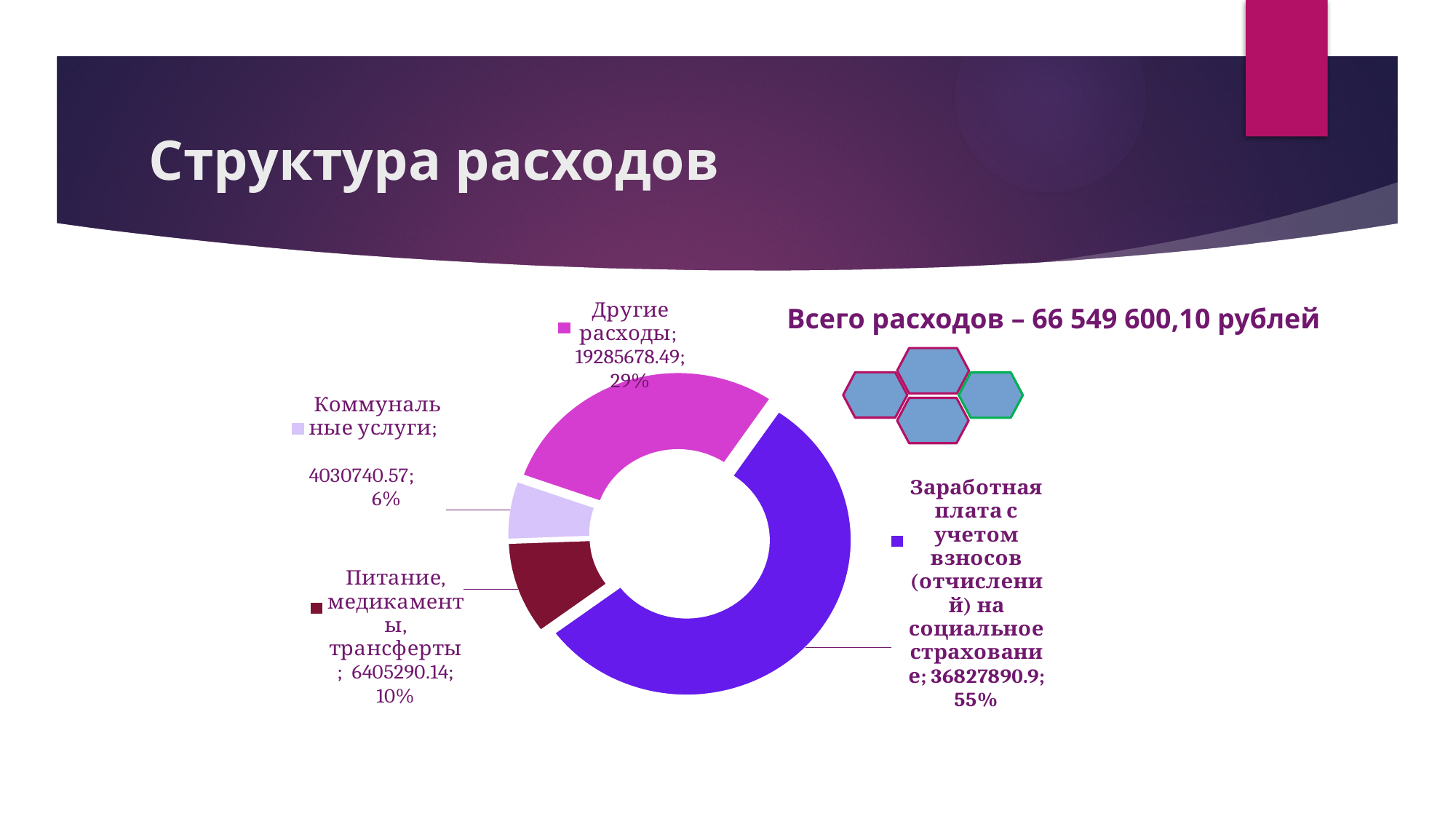
What total expenditure amount is stated on the slide next to the chart? 66 549 600,10 рублей What is the value for Заработная плата с учетом взносов (отчислений) на социальное страхование? 36827890.9 What is the value for Другие расходы? 19285678.49 What is the difference between the value for Заработная плата с учетом взносов (отчислений) на социальное страхование and the value for Другие расходы? 17542212.41 Which category has the smallest share of the chart? Коммунальные услуги What is the value for Коммунальные услуги? 4030740.57 How many categories does the chart show? 4 What share of the chart does Другие расходы represent? 29% What kind of chart is shown on the slide? doughnut (pie) chart What is the value for Питание, медикаменты, трансферты? 6405290.14 Which category has the largest share of the chart? Заработная плата с учетом взносов (отчислений) на социальное страхование What share of the chart does Питание, медикаменты, трансферты represent? 10%